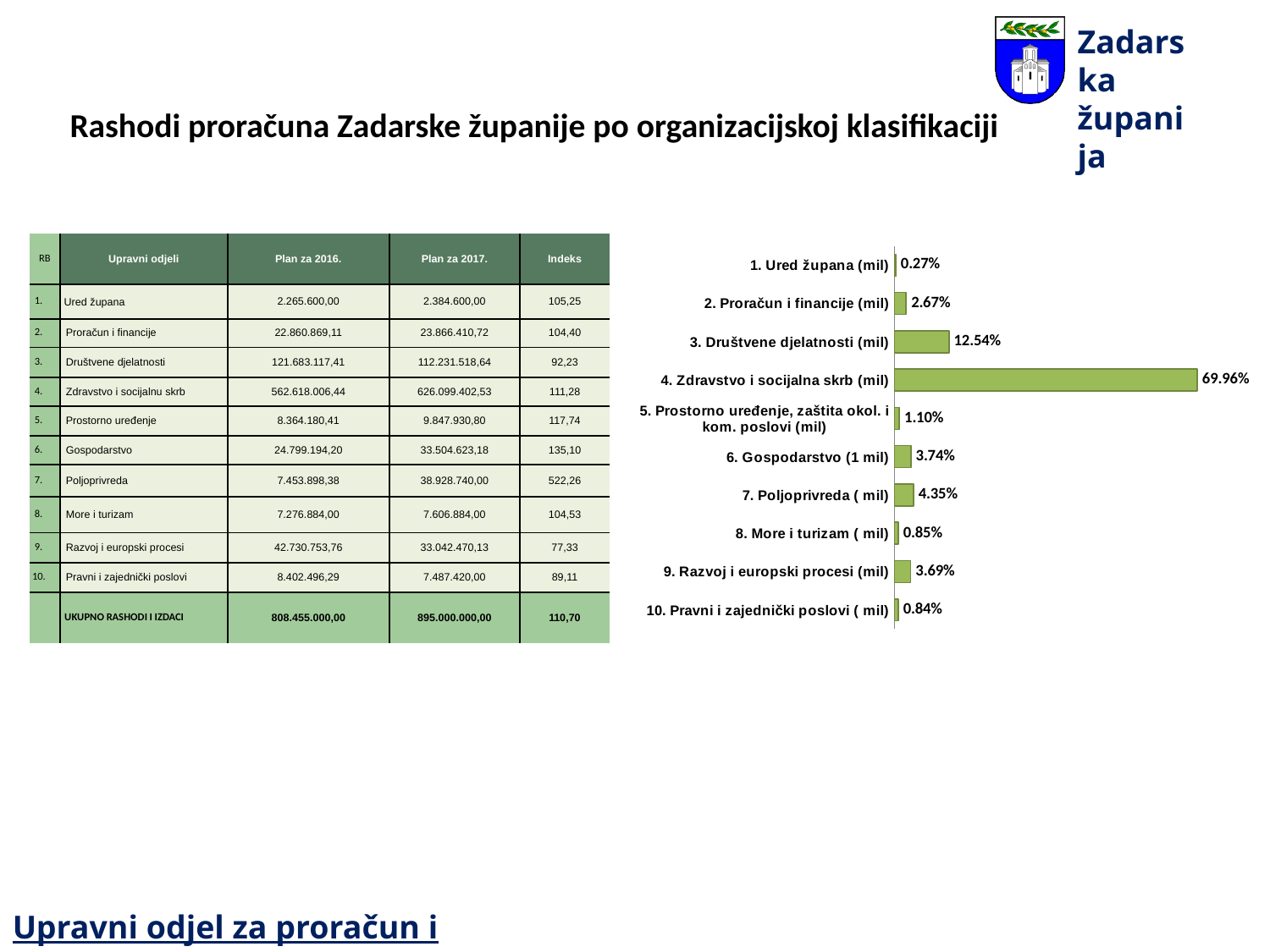
In the bar chart, what is the difference between the values for 4. Zdravstvo i socijalna skrb (mil) and 3. Društvene djelatnosti (mil)? 57.42% What is the value shown for 7. Poljoprivreda ( mil) in the bar chart? 4.35% How many categories does the bar chart show? 10 In the bar chart, which has a larger value: 7. Poljoprivreda ( mil) or 6. Gospodarstvo (1 mil)? 7. Poljoprivreda ( mil) Which category has the highest value in the bar chart? 4. Zdravstvo i socijalna skrb (mil) What is the value shown for 3. Društvene djelatnosti (mil) in the bar chart? 12.54% What is the value shown for 4. Zdravstvo i socijalna skrb (mil) in the bar chart? 69.96% What is the value shown for 10. Pravni i zajednički poslovi ( mil) in the bar chart? 0.84% What colour are the bars in the bar chart? green In the bar chart, what is the difference between the values for 3. Društvene djelatnosti (mil) and 2. Proračun i financije (mil)? 9.87% What kind of chart is shown on the right side of the slide? bar chart Which category has the lowest value in the bar chart? 1. Ured župana (mil)